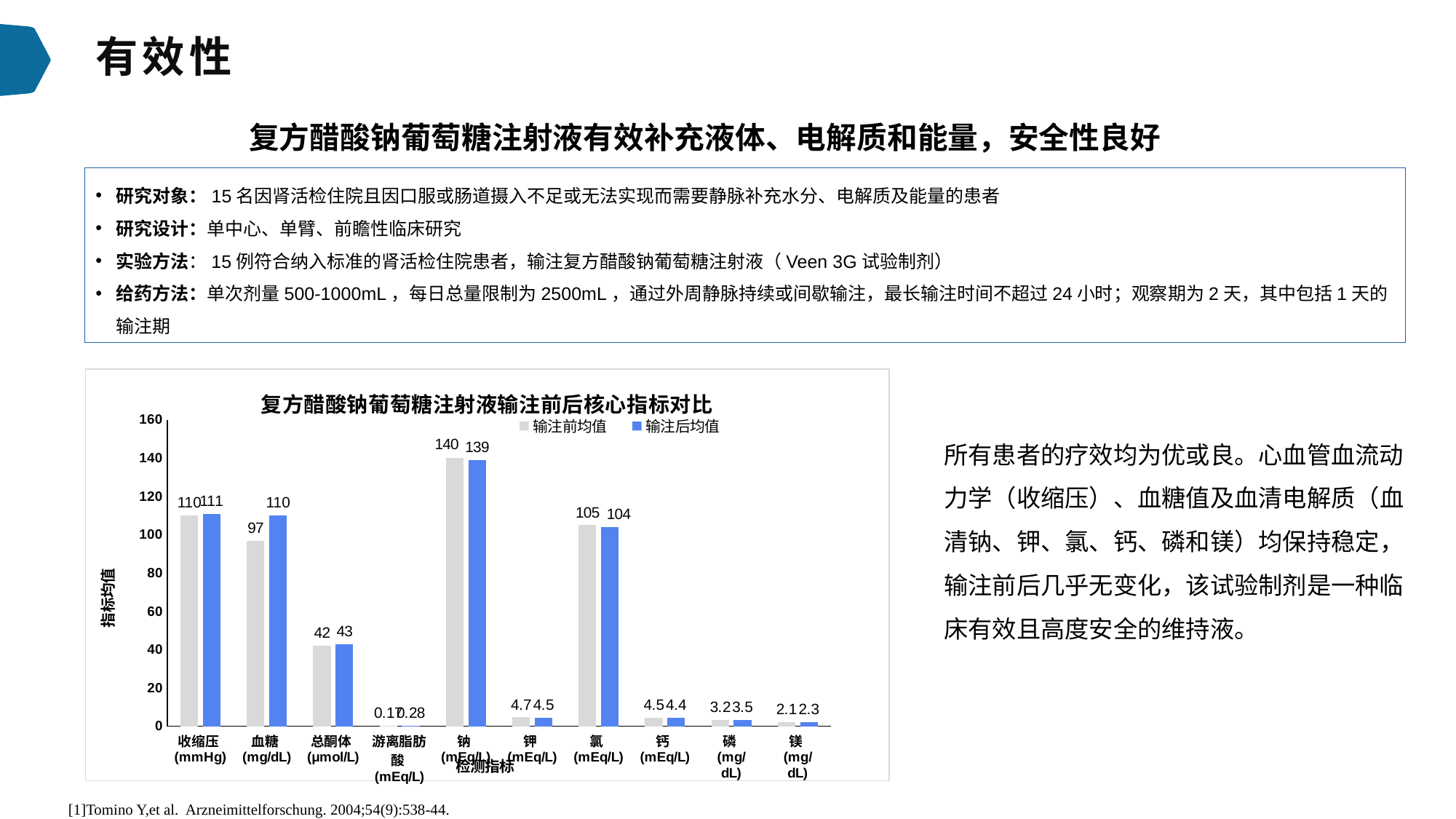
What is the title of the chart? 复方醋酸钠葡萄糖注射液输注前后核心指标对比 Which category has the lowest 输注后均值? 游离脂肪酸 (mEq/L) How many series does the legend of the chart list? 2 What is the 输注前均值 for 血糖 (mg/dL)? 97 Which category has the highest 输注前均值? 钠 (mEq/L) What is the difference between the 输注后均值 and 输注前均值 for 血糖 (mg/dL)? 13 What is the 输注前均值 for 游离脂肪酸 (mEq/L)? 0.17 For 氯 (mEq/L), which is larger: the 输注前均值 or the 输注后均值? 输注前均值 What type of chart is shown on the slide? bar chart Is the 输注前均值 for 收缩压 (mmHg) greater or less than 100? greater How many categories (检测指标) are shown on the x axis of the chart? 10 What is the 输注后均值 for 钠 (mEq/L)? 139